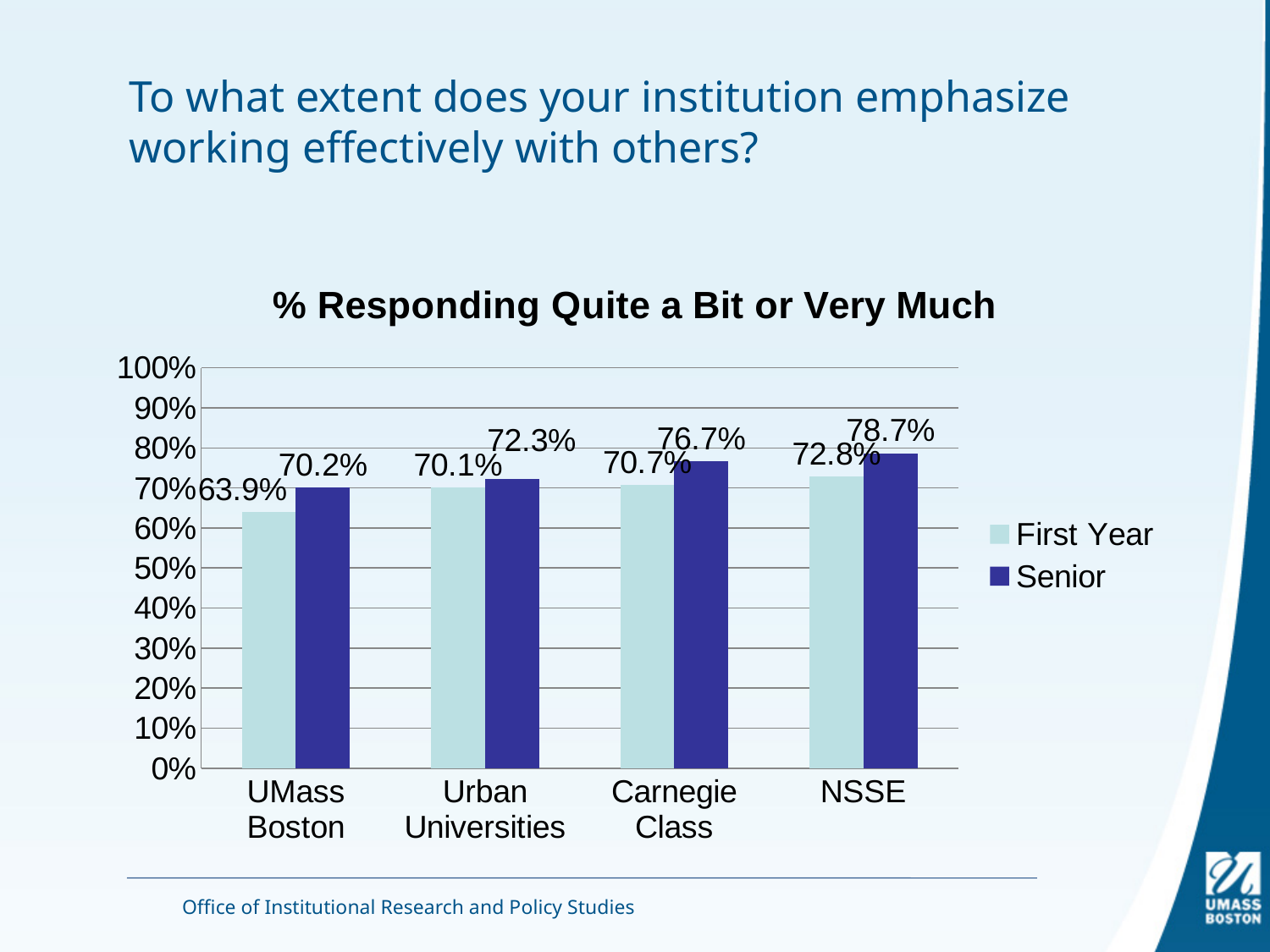
What is the Senior value for Carnegie Class? 76.7% Which is larger: the Senior value for Carnegie Class or the Senior value for Urban Universities? Senior value for Carnegie Class What is the title of the chart? % Responding Quite a Bit or Very Much What is the First Year value for Urban Universities? 70.1% How many categories are shown on the x axis? 4 What is the First Year value for UMass Boston? 63.9% How many series does the legend list? 2 Which category has the highest Senior value? NSSE What kind of chart is shown? Bar chart What is the Senior value for NSSE? 78.7% Which category has the lowest First Year value? UMass Boston What is the difference between the Senior and First Year values for UMass Boston? 6.3%